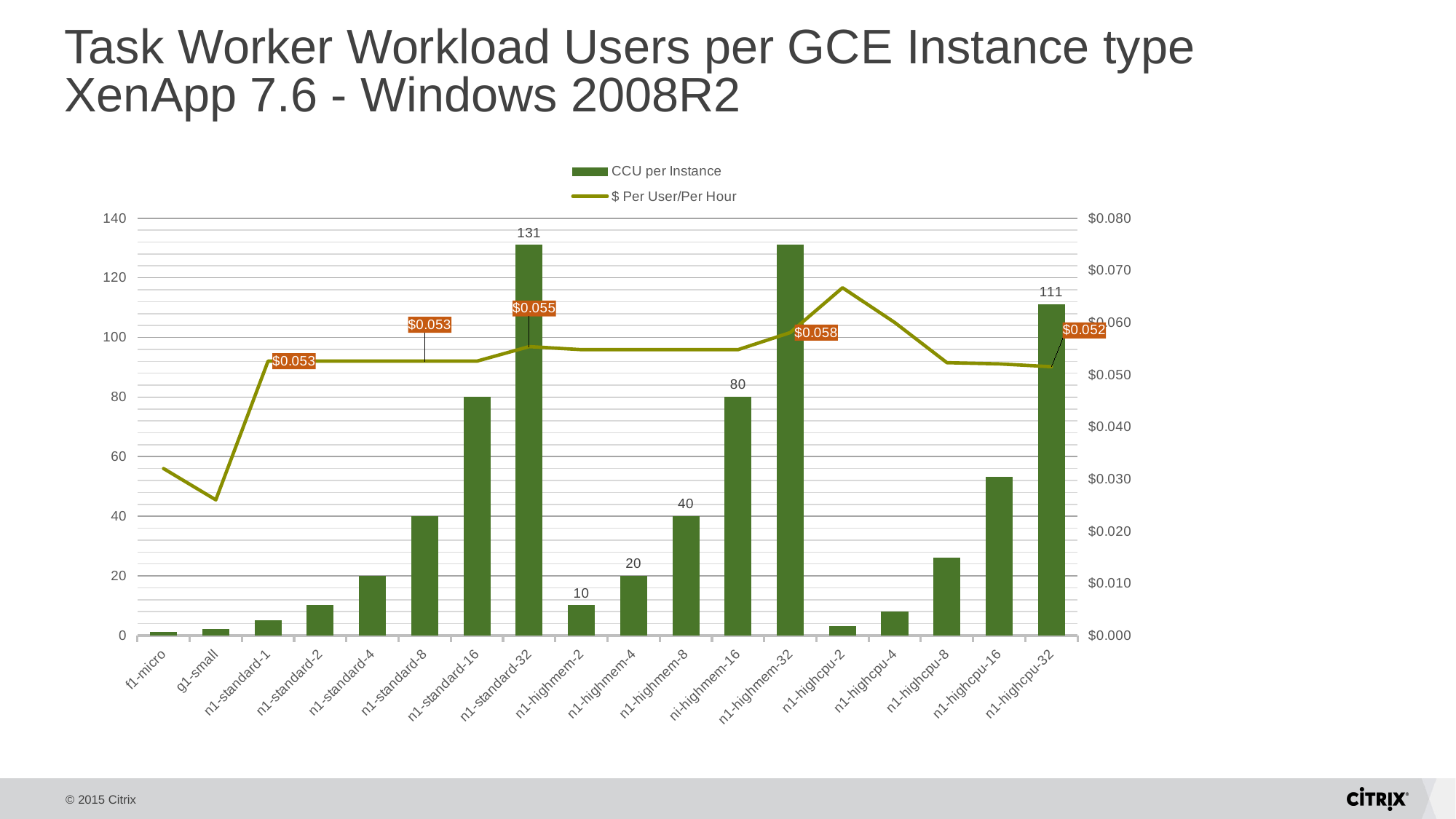
What is the CCU per Instance value for n1-standard-32? 131 How many instance types are shown on the x axis? 18 Is the CCU per Instance value for n1-highcpu-16 greater or less than 40? greater What is the CCU per Instance value for n1-highcpu-32? 111 What is the $ Per User/Per Hour value labelled at n1-highmem-32? $0.058 What is the $ Per User/Per Hour value labelled at n1-highcpu-32? $0.052 What is the difference in CCU per Instance between n1-standard-32 and n1-highcpu-32? 20 Is the CCU per Instance value for n1-standard-16 greater or less than 60? greater Which has a higher CCU per Instance, n1-highmem-8 or n1-highmem-4? n1-highmem-8 What is the difference in CCU per Instance between ni-highmem-16 and n1-highmem-8? 40 How many series does the legend list? 2 What is the CCU per Instance value for ni-highmem-16? 80